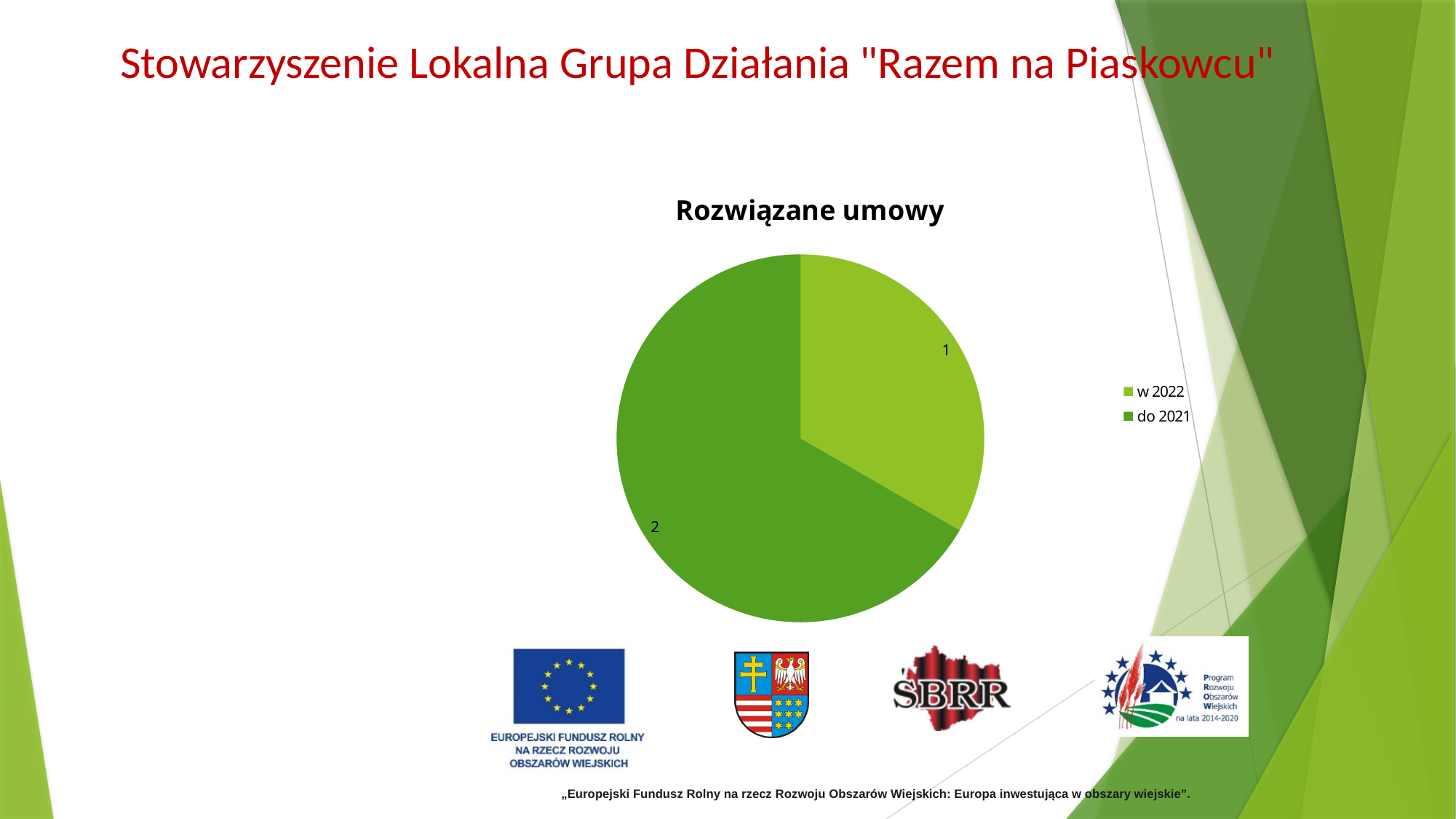
Which slice of the pie is the largest? do 2021 What is the title of the chart? Rozwiązane umowy What is the value of the "do 2021" slice? 2 What is the difference between the values for "do 2021" and "w 2022"? 1 Which legend entry is shown in the lighter green colour? w 2022 Which is larger, the value for "w 2022" or the value for "do 2021"? do 2021 What is the value of the "w 2022" slice? 1 How many slices does the pie chart have? 2 What kind of chart is shown on the slide? pie chart What is the total of all slices in the pie chart? 3 Which slice of the pie is the smallest? w 2022 How many entries does the legend list? 2